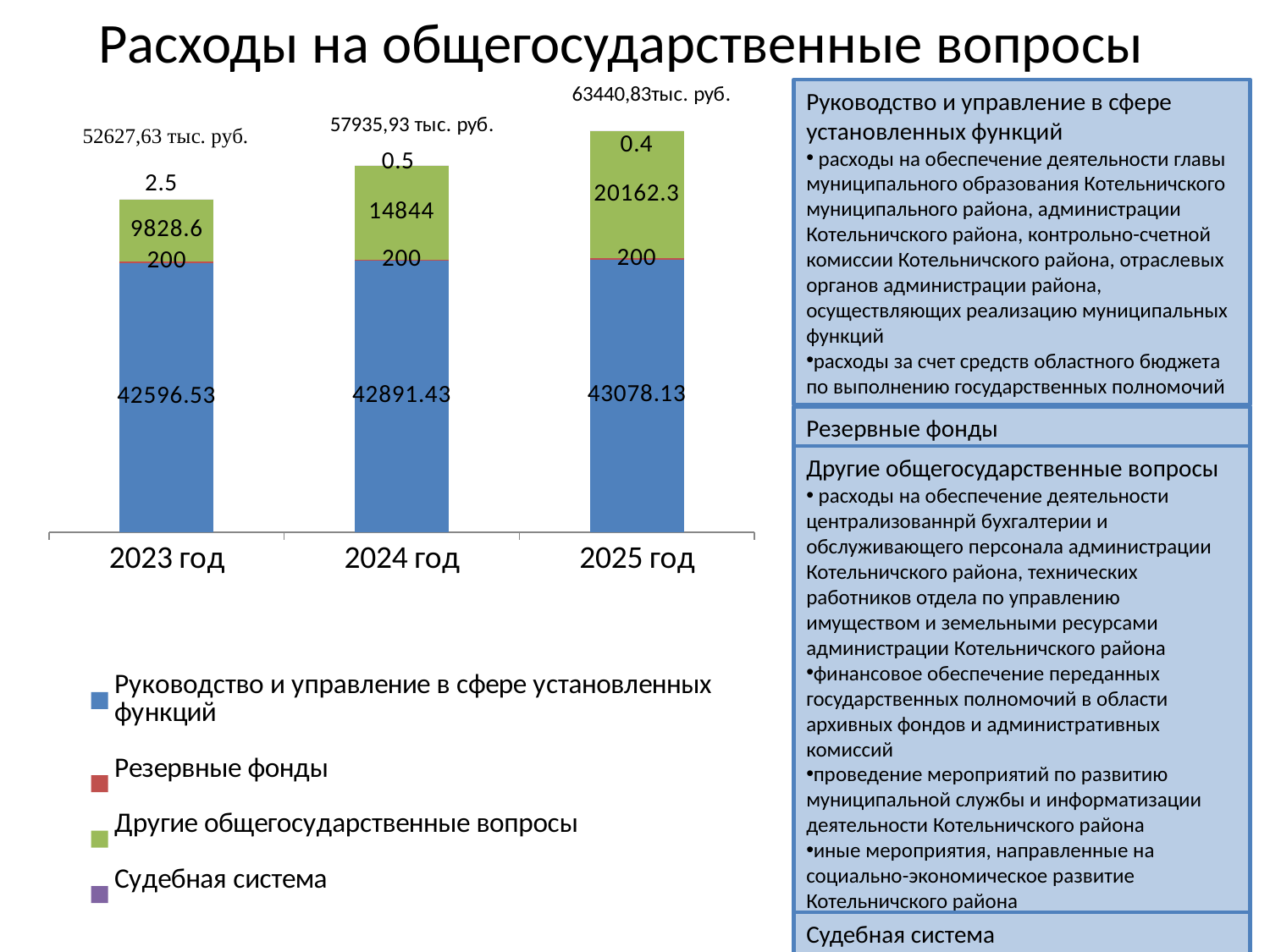
What is the difference between the 'Другие общегосударственные вопросы' values for 2024 год and 2023 год? 5015.4 How many year categories are shown on the x axis? 3 How many series does the legend list? 4 What is the value of 'Другие общегосударственные вопросы' for 2025 год? 20162.3 Does the value of 'Другие общегосударственные вопросы' rise or fall from 2023 год to 2025 год? rise What total is printed above the bar for 2024 год? 57935,93 тыс. руб. Which year has the highest value for 'Другие общегосударственные вопросы'? 2025 год What is the value of 'Судебная система' for 2024 год? 0.5 What type of chart is shown on the slide? stacked bar chart What is the value of 'Руководство и управление в сфере установленных функций' for 2023 год? 42596.53 Which year has the lowest value for 'Руководство и управление в сфере установленных функций'? 2023 год What is the value of 'Резервные фонды' for 2025 год? 200